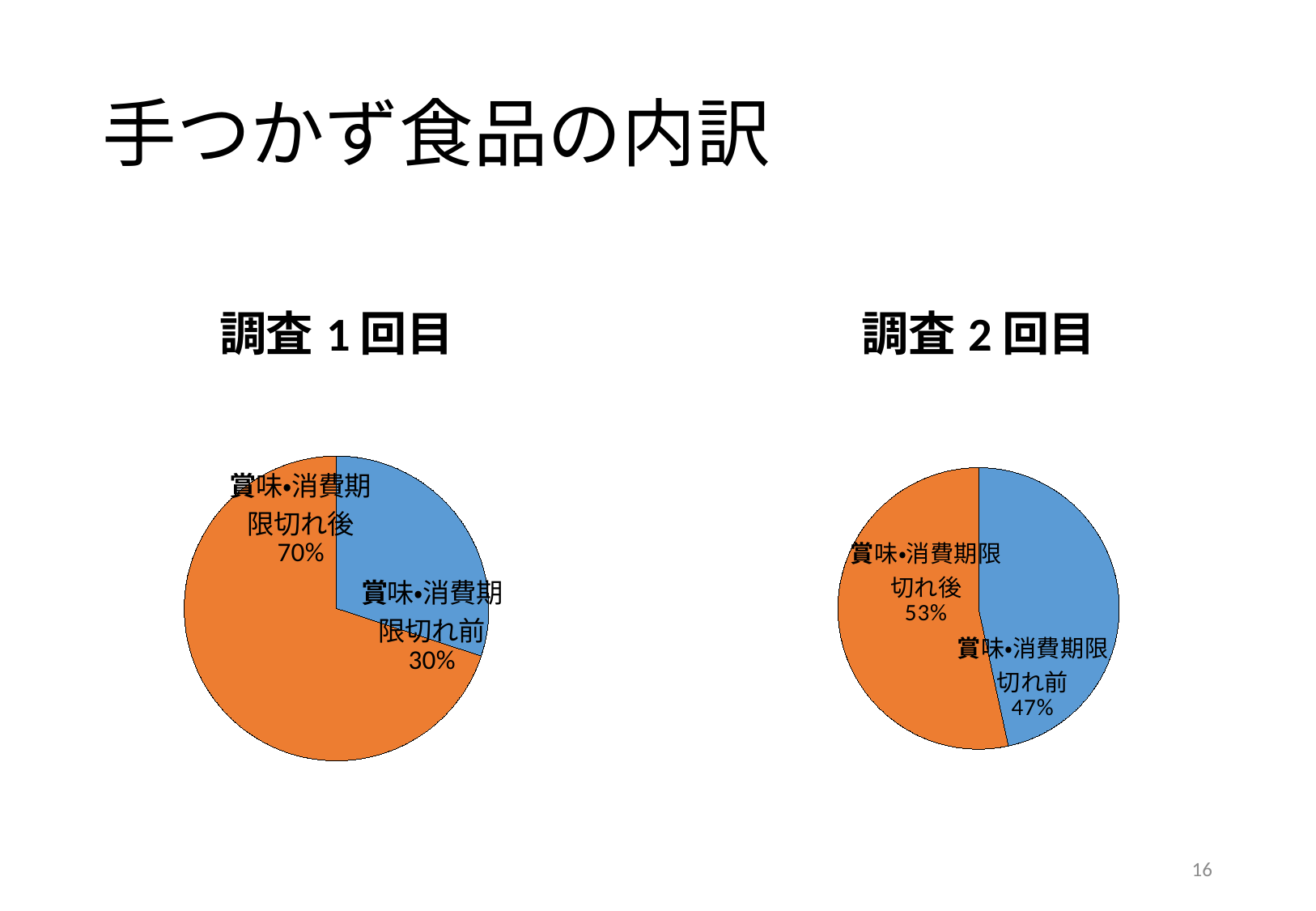
How many slices does the 調査１回目 pie chart have? 2 In the 調査２回目 pie chart, what share is labelled for 賞味•消費期限切れ後? 53% In the 調査２回目 pie chart, what share is labelled for 賞味•消費期限切れ前? 47% In the 調査１回目 pie chart, which slice is the largest? 賞味•消費期限切れ後 In the 調査１回目 pie chart, what share is labelled for 賞味•消費期限切れ前? 30% In the 調査１回目 pie chart, what share is labelled for 賞味•消費期限切れ後? 70% In the 調査２回目 pie chart, what is the difference between the 賞味•消費期限切れ後 share and the 賞味•消費期限切れ前 share? 6% In the 調査２回目 pie chart, which slice is the smallest? 賞味•消費期限切れ前 In the 調査１回目 pie chart, what is the difference between the 賞味•消費期限切れ後 share and the 賞味•消費期限切れ前 share? 40% Which is larger: the 賞味•消費期限切れ前 share in 調査１回目 or in 調査２回目? 調査２回目 What colour is the 賞味•消費期限切れ後 slice in the 調査１回目 pie chart? Orange What type of chart is used for 調査２回目? Pie chart